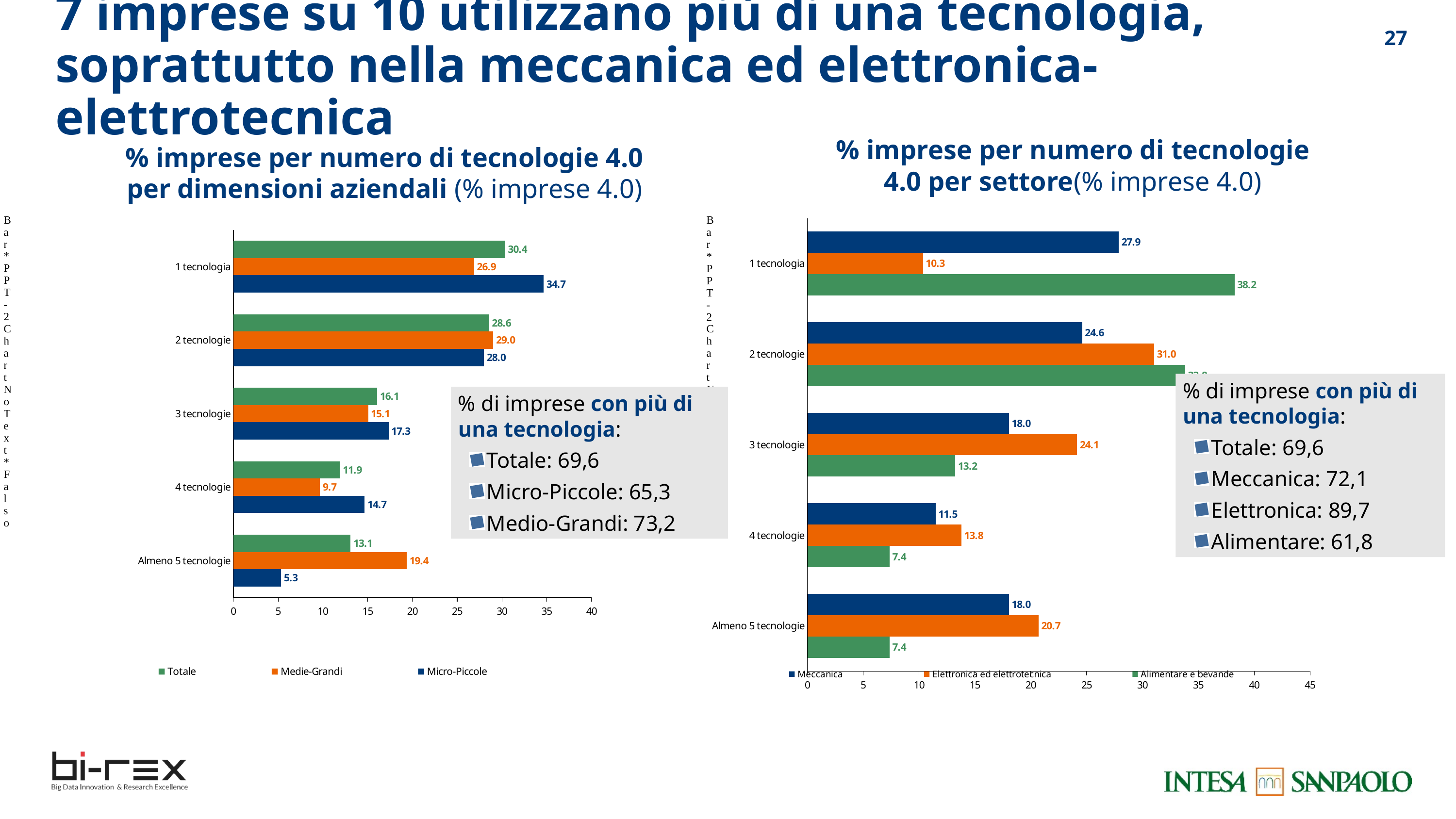
In the left chart (per dimensioni aziendali), which is larger for 3 tecnologie: Totale or Micro-Piccole? Micro-Piccole In the right chart (per settore), what is the difference between the Elettronica ed elettrotecnica and Meccanica values for Almeno 5 tecnologie? 2.7 In the right chart (per settore), what is the Alimentare e bevande value for 1 tecnologia? 38.2 In the left chart (per dimensioni aziendali), what is the Medie-Grandi value for Almeno 5 tecnologie? 19.4 In the left chart (per dimensioni aziendali), what is the Micro-Piccole value for 1 tecnologia? 34.7 In the right chart (per settore), which category has the highest Meccanica value? 1 tecnologia In the right chart (per settore), what is the Elettronica ed elettrotecnica value for 3 tecnologie? 24.1 In the left chart (per dimensioni aziendali), how many series does the legend list? 3 In the left chart (per dimensioni aziendali), what is the difference between the Micro-Piccole and Medie-Grandi values for 4 tecnologie? 5.0 What type of chart is the right chart (per settore)? Bar chart In the right chart (per settore), how many categories are shown on the vertical axis? 5 In the left chart (per dimensioni aziendali), which category has the lowest Micro-Piccole value? Almeno 5 tecnologie